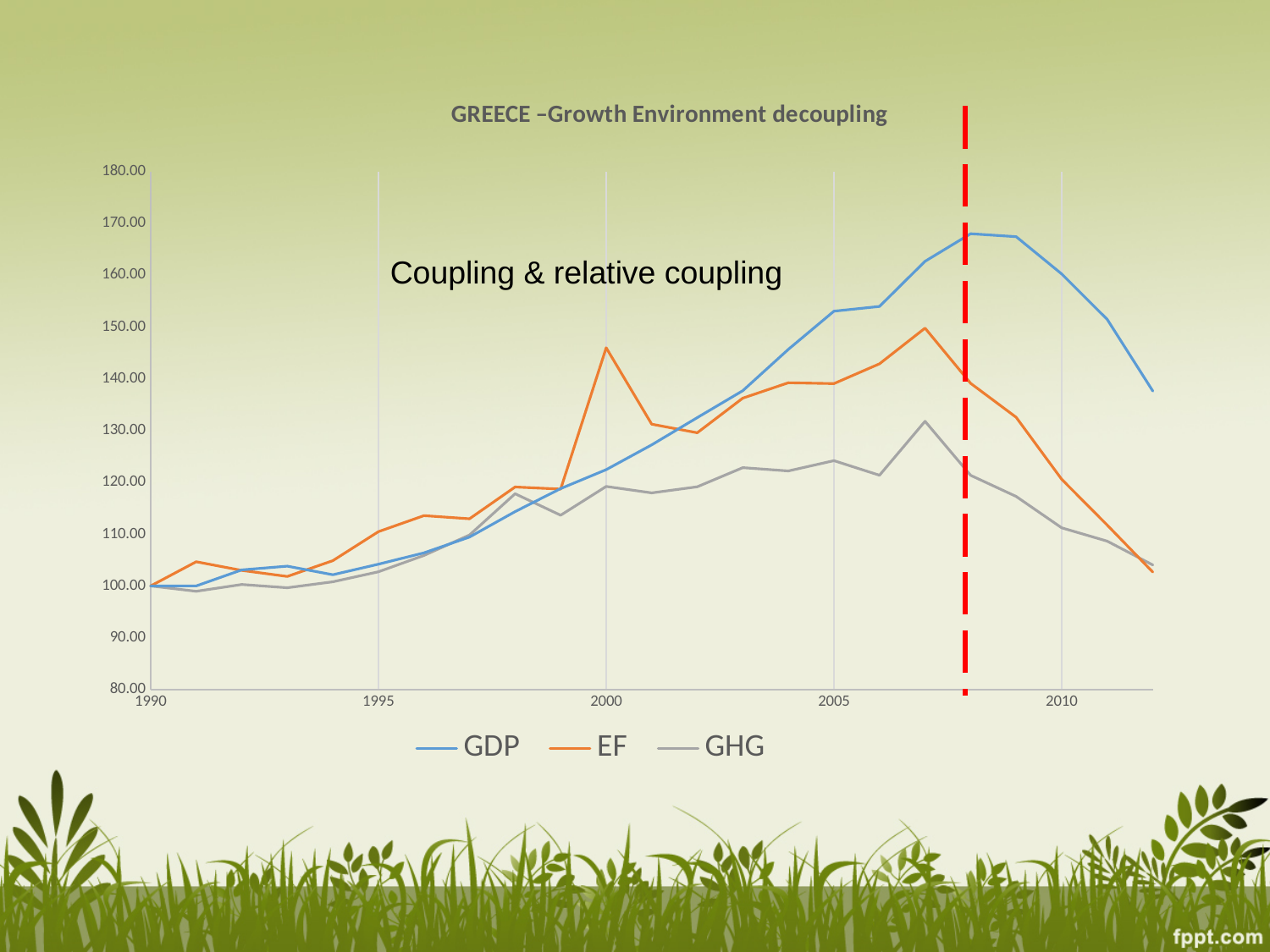
Which series are listed in the legend? GDP, EF, GHG What is the title of the chart? GREECE –Growth Environment decoupling Is the EF value in 2000 greater or less than 140.00? greater Which series has the highest value in 2008? GDP Is the GDP value in 2012 greater or less than 140.00? less How many series does the legend list? 3 What kind of chart is shown on the slide? line chart Which series has the lowest value in 2005? GHG In 2000, which is larger, the EF value or the GDP value? EF Does the GDP line rise or fall between 2008 and 2012? fall Is the GDP value in 2008 greater or less than 160.00? greater